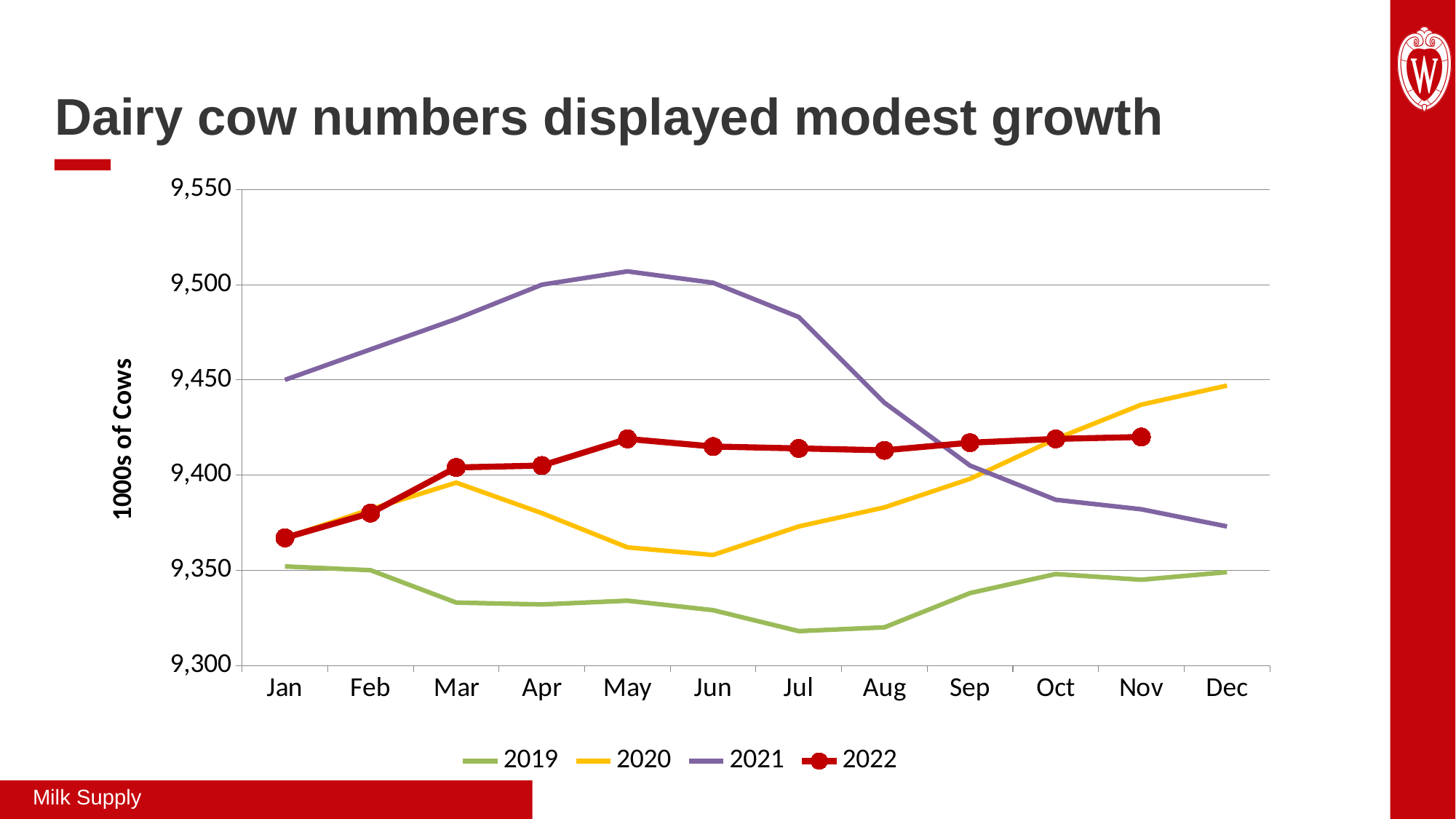
Is the value for 2021 in Dec greater or less than 9,400? less What kind of chart is shown on the slide? line chart Does the 2021 series rise or fall from May to Dec? fall How many series does the legend list? 4 Which series has the higher value in Nov, 2020 or 2021? 2020 In which month does the 2020 series reach its lowest value? Jun In which month does the 2022 series have its lowest value? Jan In which month does the 2021 series reach its highest value? May Is the value for 2019 in Jul greater or less than 9,350? less Is the value for 2021 in Apr greater or less than 9,450? greater In which month does the 2019 series reach its lowest value? Jul How many months are shown on the x axis? 12